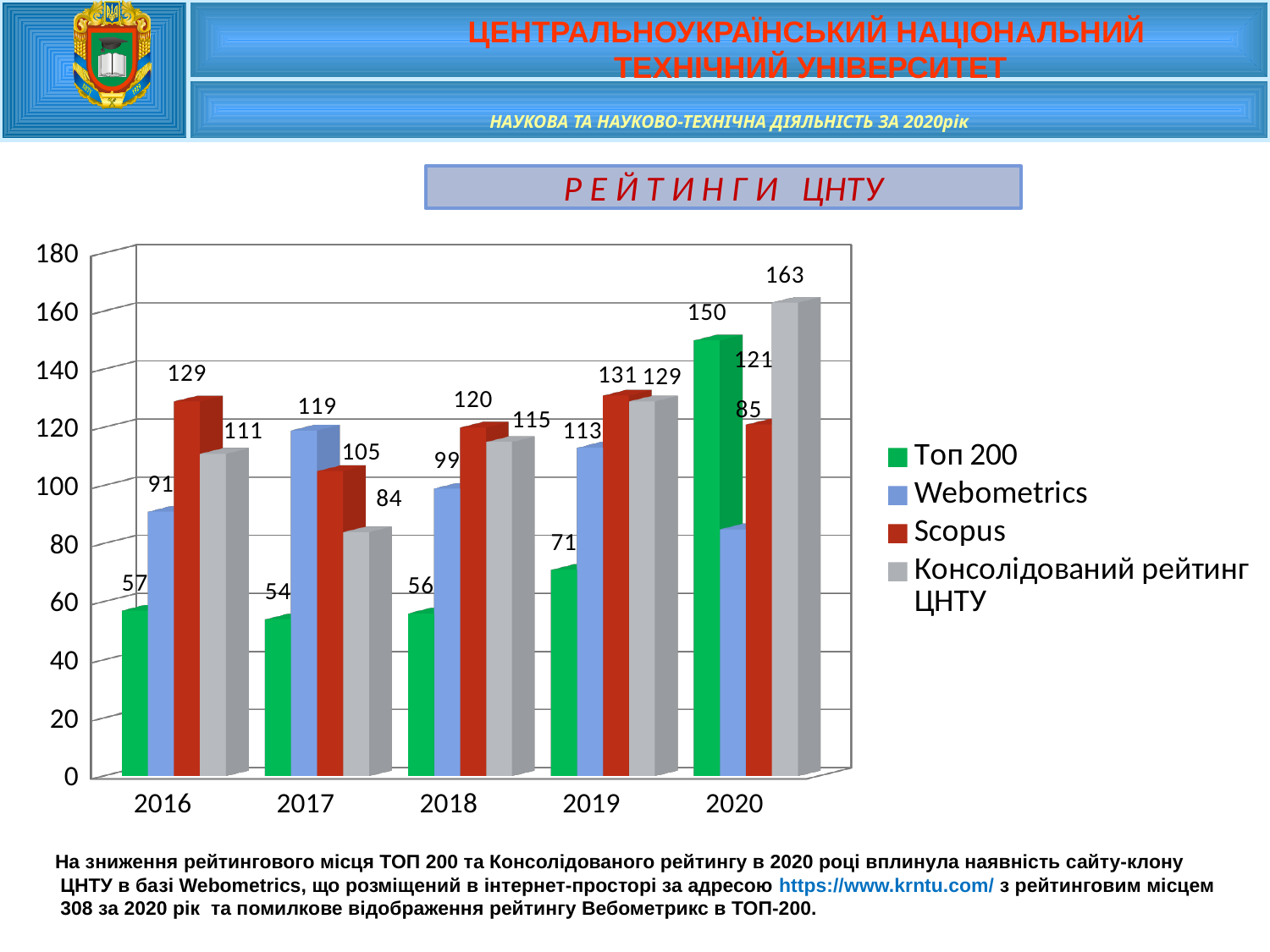
What is the Webometrics value for 2017? 119 What is the Scopus value for 2016? 129 In which year is the Топ 200 value lowest? 2017 Which colour represents the Scopus series in the chart? red What is the Консолідований рейтинг ЦНТУ value for 2018? 115 How many years are shown on the x axis? 5 What is the Топ 200 value for 2020? 150 How many series does the legend list? 4 What kind of chart is shown on the slide? bar chart In which year is the Консолідований рейтинг ЦНТУ value highest? 2020 Which is larger in 2020: the Webometrics value or the Scopus value? Scopus What is the difference between the Scopus value and the Топ 200 value in 2019? 60